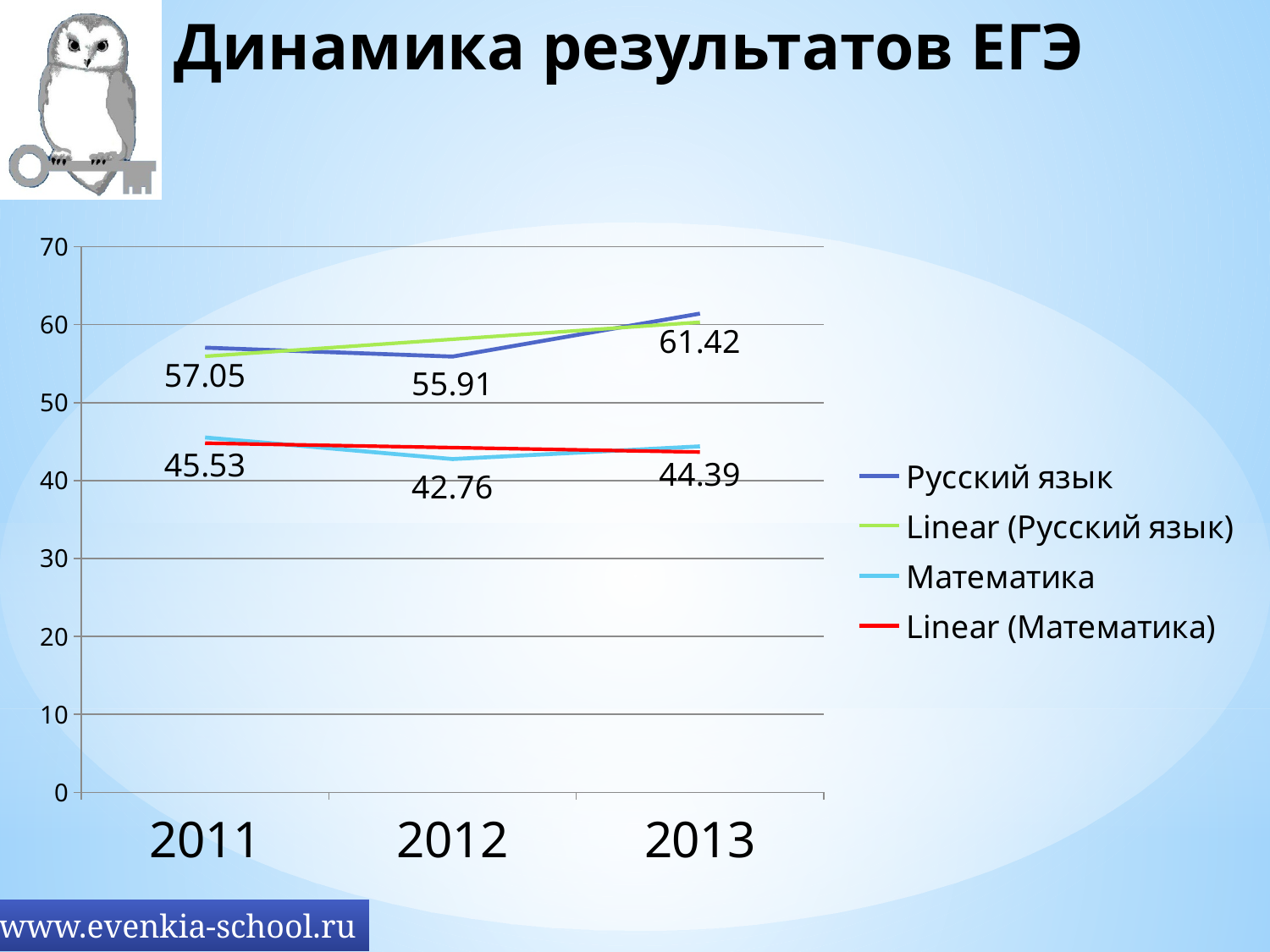
What is the value for Математика in 2013? 44.39 What is the difference between the Русский язык values in 2013 and 2012? 5.51 How many entries does the legend list? 4 In which year is the Математика value lowest? 2012 What is the value for Русский язык in 2011? 57.05 Which is larger in 2011: the value for Русский язык or the value for Математика? Русский язык What is the value for Математика in 2012? 42.76 Is the value for Математика in 2011 greater or less than 50? less What kind of chart is shown on the slide? line chart How many years are shown on the x axis? 3 In which year is the Русский язык value highest? 2013 What is the value for Русский язык in 2013? 61.42